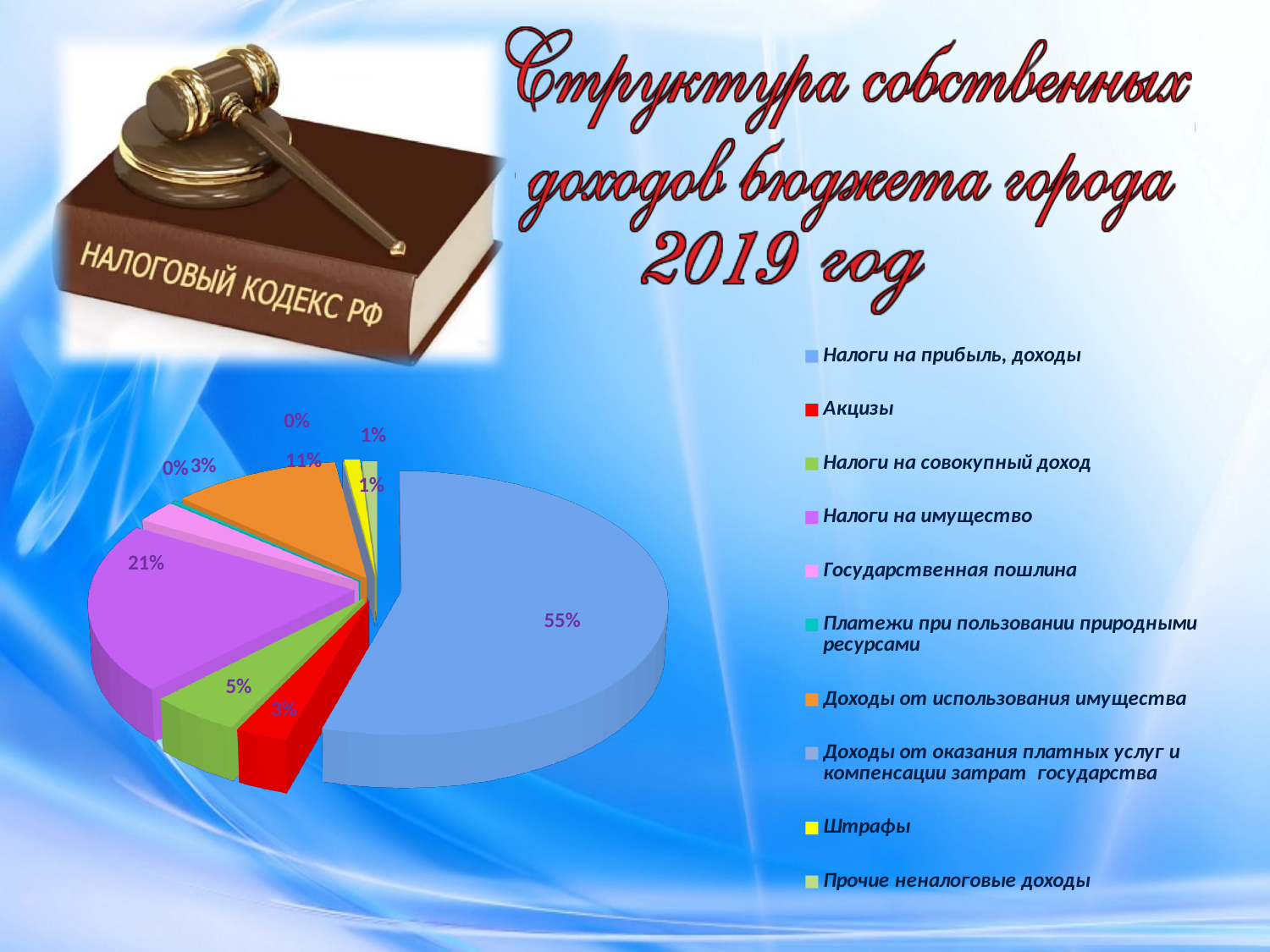
Which category has the largest share of the pie? Налоги на прибыль, доходы What share of the pie does "Штрафы" have? 1% What share of the pie does "Налоги на имущество" have? 21% What type of chart is shown on the slide? pie chart What is the difference between the share for "Налоги на прибыль, доходы" and the share for "Налоги на имущество"? 34% What colour is the slice for "Акцизы"? red What share of the pie does "Акцизы" have? 3% What share of the pie does "Налоги на прибыль, доходы" have? 55% What share of the pie does "Доходы от использования имущества" have? 11% How many categories does the legend list? 10 Which is larger: the share for "Налоги на имущество" or the share for "Доходы от использования имущества"? Налоги на имущество What share of the pie does "Налоги на совокупный доход" have? 5%